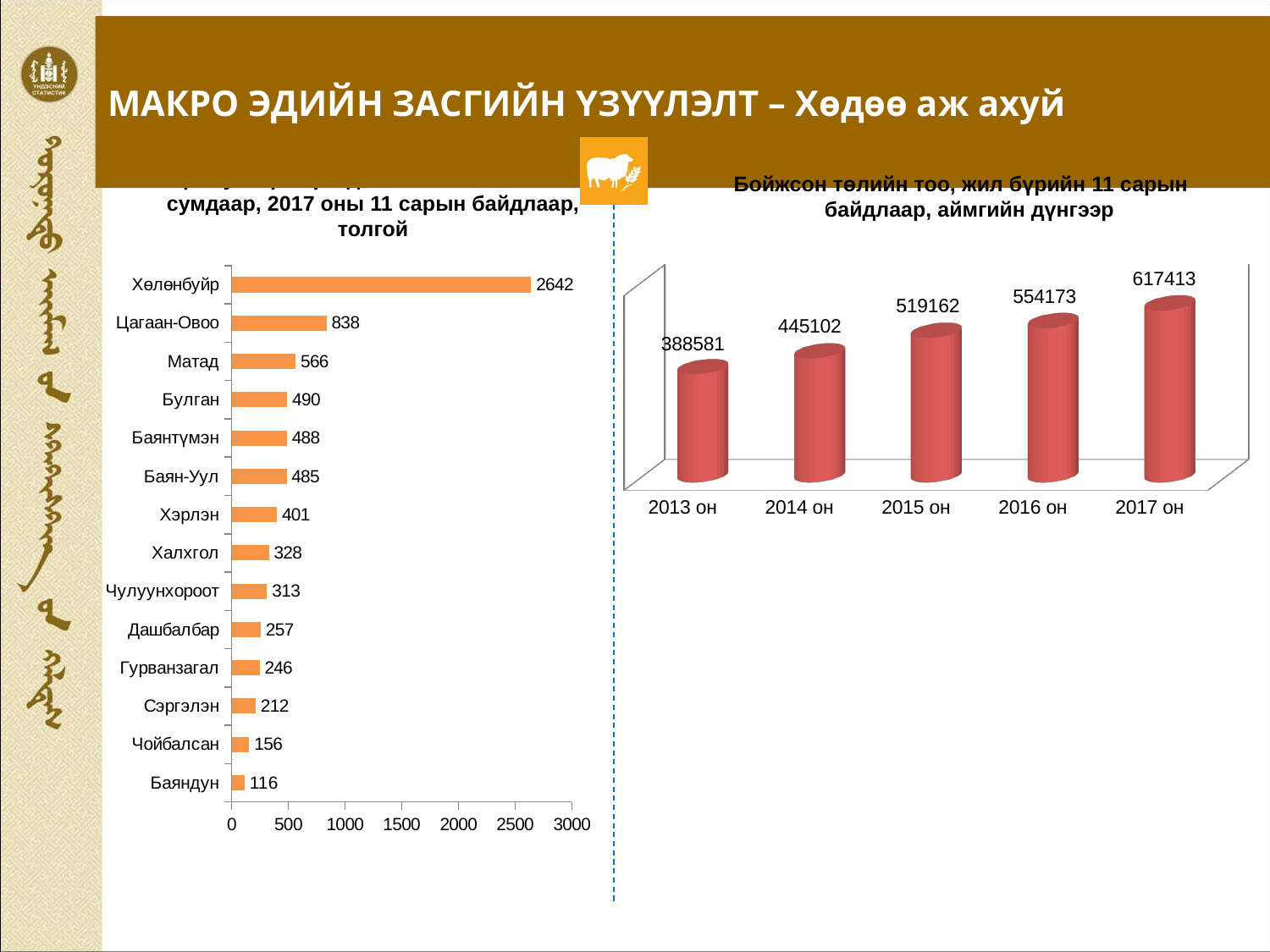
In the chart titled 'Бойжсон төлийн тоо, жил бүрийн 11 сарын байдлаар, аймгийн дүнгээр', do the values rise or fall from 2013 он to 2017 он? Rise What kind of chart is the left chart? Bar chart In the left chart, what is the difference between the values for Цагаан-Овоо and Матад? 272 In the left chart, what is the value for Хөлөнбуйр? 2642 In the chart titled 'Бойжсон төлийн тоо, жил бүрийн 11 сарын байдлаар, аймгийн дүнгээр', what is the difference between the values for 2017 он and 2013 он? 228832 In the chart titled 'Бойжсон төлийн тоо, жил бүрийн 11 сарын байдлаар, аймгийн дүнгээр', which year has the highest value? 2017 он In the left chart, which category has the highest value? Хөлөнбуйр In the chart titled 'Бойжсон төлийн тоо, жил бүрийн 11 сарын байдлаар, аймгийн дүнгээр', how many years are shown? 5 In the left chart, which category has the lowest value? Баяндун In the left chart, what is the value for Чулуунхороот? 313 In the left chart, how many categories are shown? 14 In the chart titled 'Бойжсон төлийн тоо, жил бүрийн 11 сарын байдлаар, аймгийн дүнгээр', what is the value for 2015 он? 519162